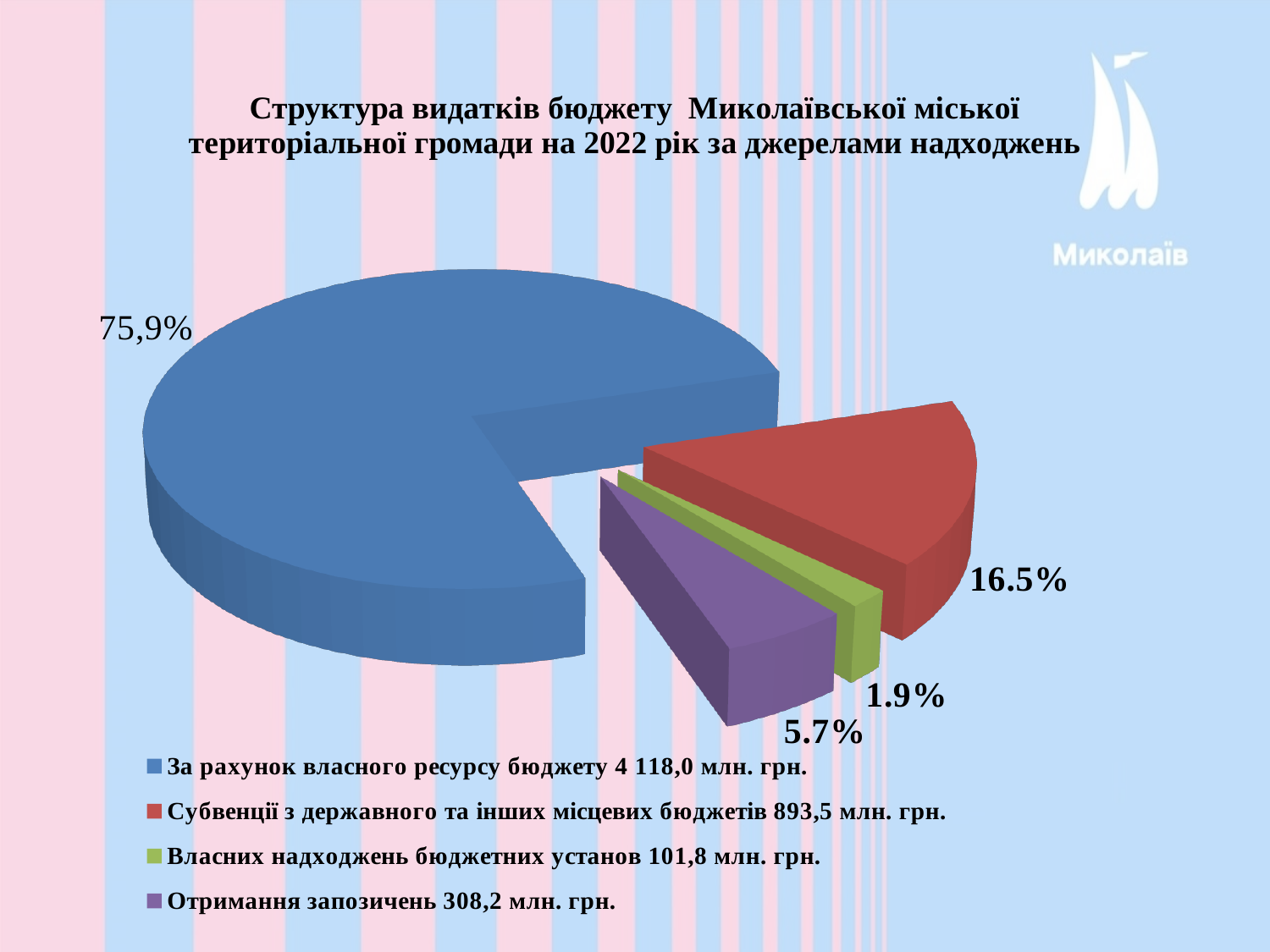
Which source has the smallest share of the pie? Власних надходжень бюджетних установ What share of the pie is labelled for 'Отримання запозичень'? 5.7% What is the difference in percentage points between the 'Субвенції' slice (16.5%) and the 'Отримання запозичень' slice (5.7%)? 10.8 Which source has the largest share of the pie? За рахунок власного ресурсу бюджету How many slices does the pie chart have? 4 Which is larger: the share for 'Отримання запозичень' or the share for 'Власних надходжень бюджетних установ'? Отримання запозичень What colour is the slice for 'Отримання запозичень'? purple What share of the pie is labelled for 'Власних надходжень бюджетних установ'? 1.9% How many entries does the legend list? 4 What share of the pie is labelled for 'За рахунок власного ресурсу бюджету'? 75,9% What kind of chart is shown on the slide? pie chart